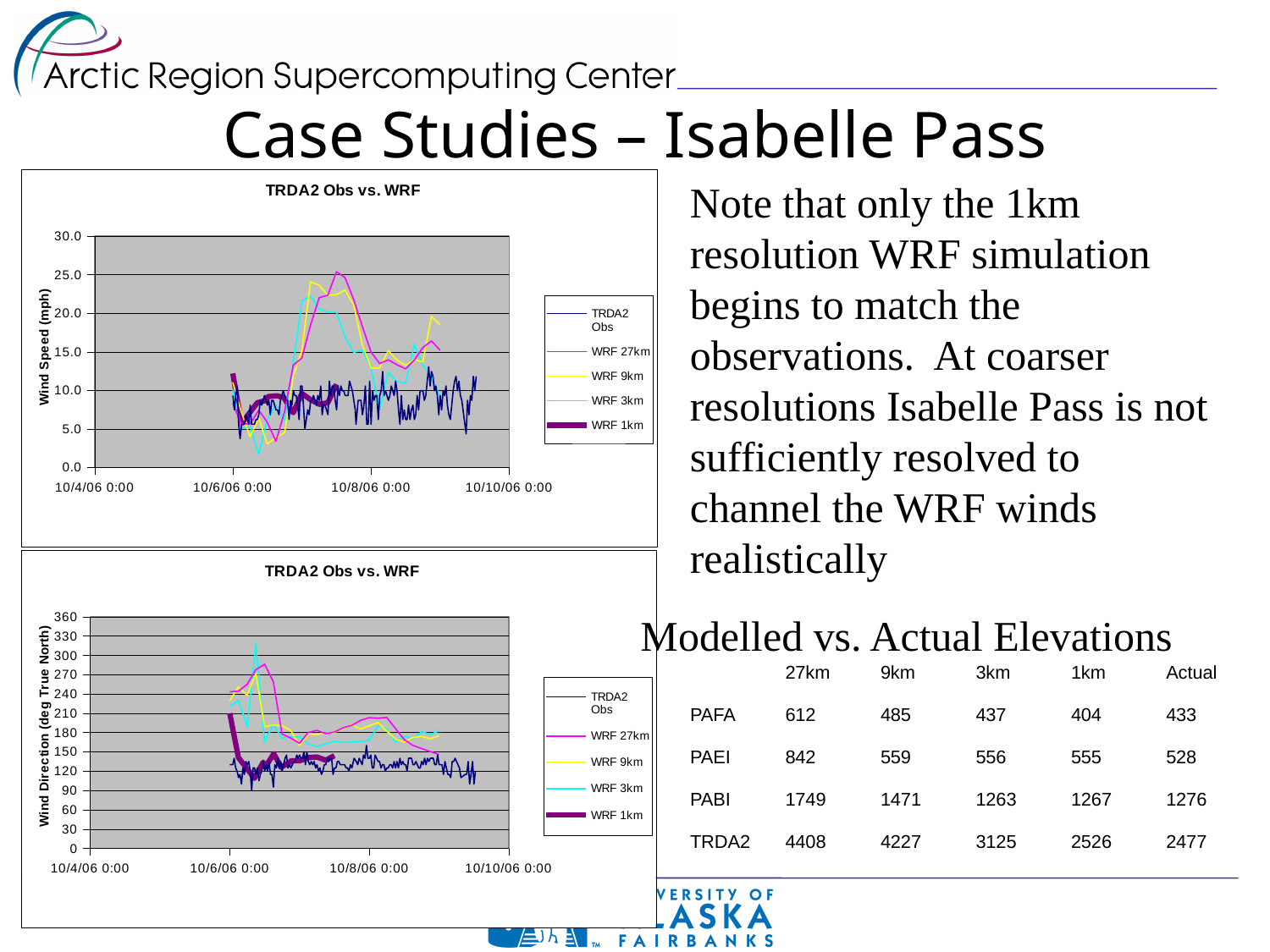
How many series does the legend of the bottom chart list? 5 What is the y-axis label of the bottom chart? Wind Direction (deg True North) In the bottom chart, is the peak value of the WRF 3km series greater or less than 270? greater What kind of chart is the top chart titled "TRDA2 Obs vs. WRF"? line chart In the top chart, is the peak value of the WRF 27km series greater or less than 20.0? greater In the top chart, around 10/7/06, which is larger: the WRF 27km series or the TRDA2 Obs series? WRF 27km What kind of chart is the bottom chart titled "TRDA2 Obs vs. WRF"? line chart How many series does the legend of the top chart list? 5 What is the y-axis label of the top chart? Wind Speed (mph) In the bottom chart, is the TRDA2 Obs series after 10/6/06 mostly greater or less than 180? less How many date labels are shown on the x axis of the top chart? 4